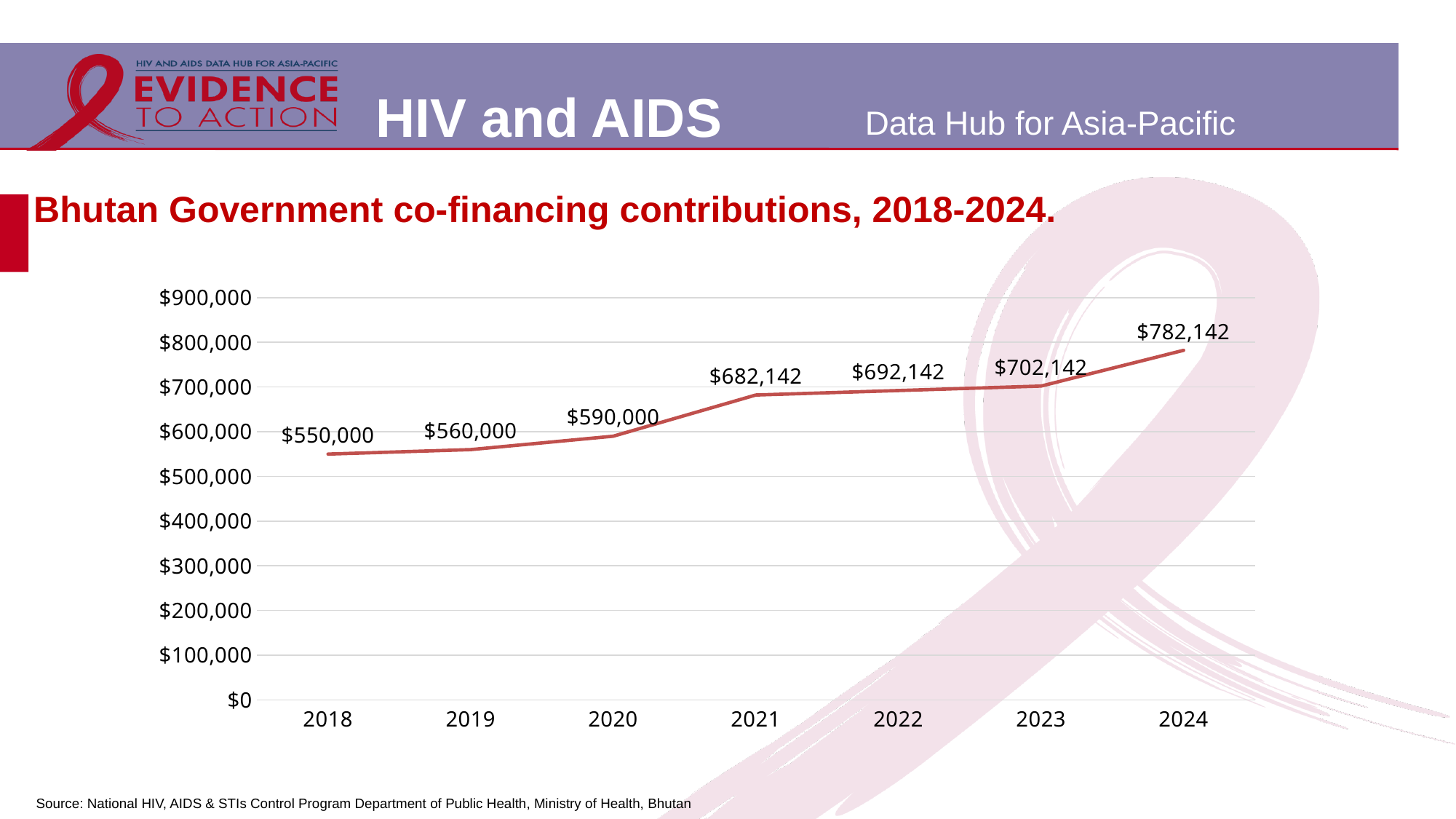
How many years are plotted on the chart? 7 Is the value for 2023 greater or less than $600,000? greater Which year had the lowest co-financing contribution? 2018 What was the Bhutan Government co-financing contribution in 2018? $550,000 Do the contributions rise or fall from 2018 to 2024? Rise Which is larger, the contribution in 2020 or in 2022? 2022 Which year had the highest co-financing contribution? 2024 What is the difference between the 2021 and 2020 contributions? $92,142 What kind of chart is shown on the slide? Line chart What was the Bhutan Government co-financing contribution in 2024? $782,142 What was the Bhutan Government co-financing contribution in 2021? $682,142 What is the difference between the 2024 and 2018 contributions? $232,142